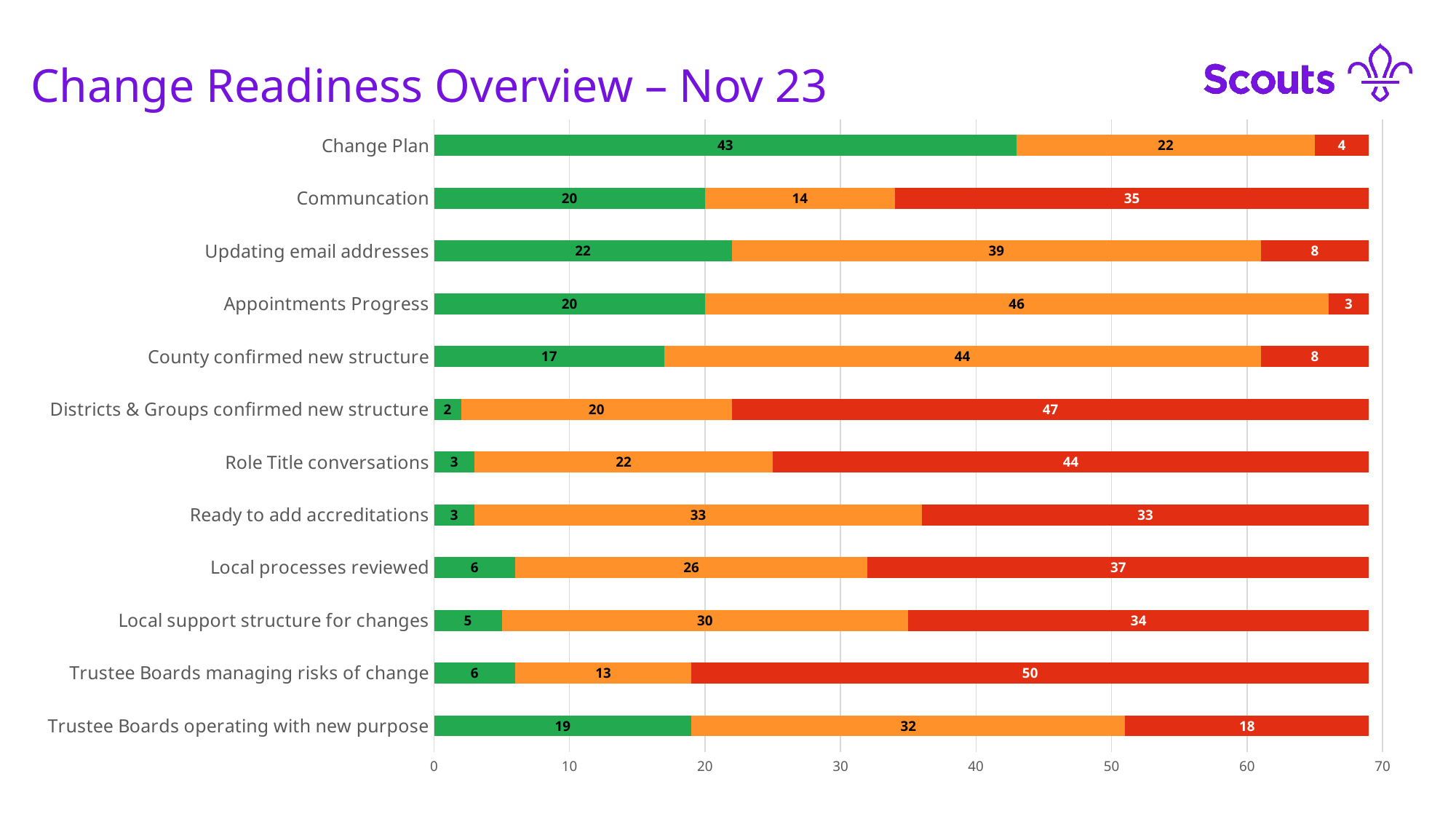
What is the green segment value for Change Plan? 43 Which category has the largest green segment? Change Plan What is the orange segment value for Appointments Progress? 46 How many categories are shown on the chart? 12 What kind of chart is shown on the slide? Stacked bar chart What is the red segment value for Communcation? 35 What is the red segment value for Trustee Boards managing risks of change? 50 Which is larger: the red segment for Communcation or the red segment for Local processes reviewed? Local processes reviewed Which category has the largest red segment? Trustee Boards managing risks of change What is the total of the stacked bar for Change Plan? 69 What is the difference between the green segment for Change Plan and the green segment for Communcation? 23 Which category has the smallest green segment? Districts & Groups confirmed new structure